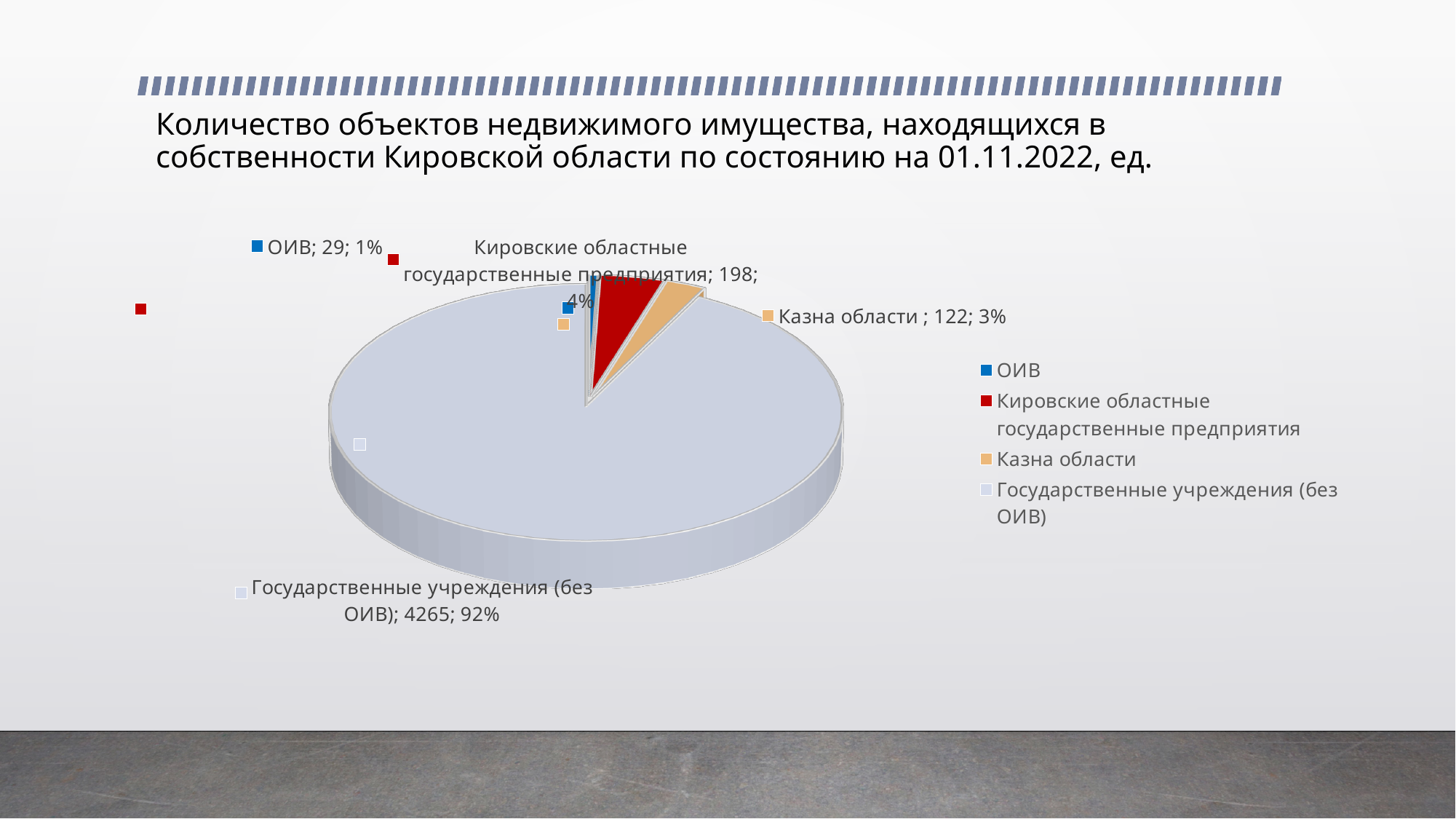
What is the value for Кировские областные государственные предприятия? 198 What is the value for Государственные учреждения (без ОИВ)? 4265 What share of the pie does Казна области represent? 3% What kind of chart is shown on the slide? Pie chart Which category has the smallest slice? ОИВ Which category has the largest slice? Государственные учреждения (без ОИВ) How many slices does the pie chart have? 4 What is the value for Казна области? 122 What is the value for ОИВ? 29 What share of the pie does Государственные учреждения (без ОИВ) represent? 92% What is the difference between the values for Кировские областные государственные предприятия and Казна области? 76 How many entries does the legend list? 4